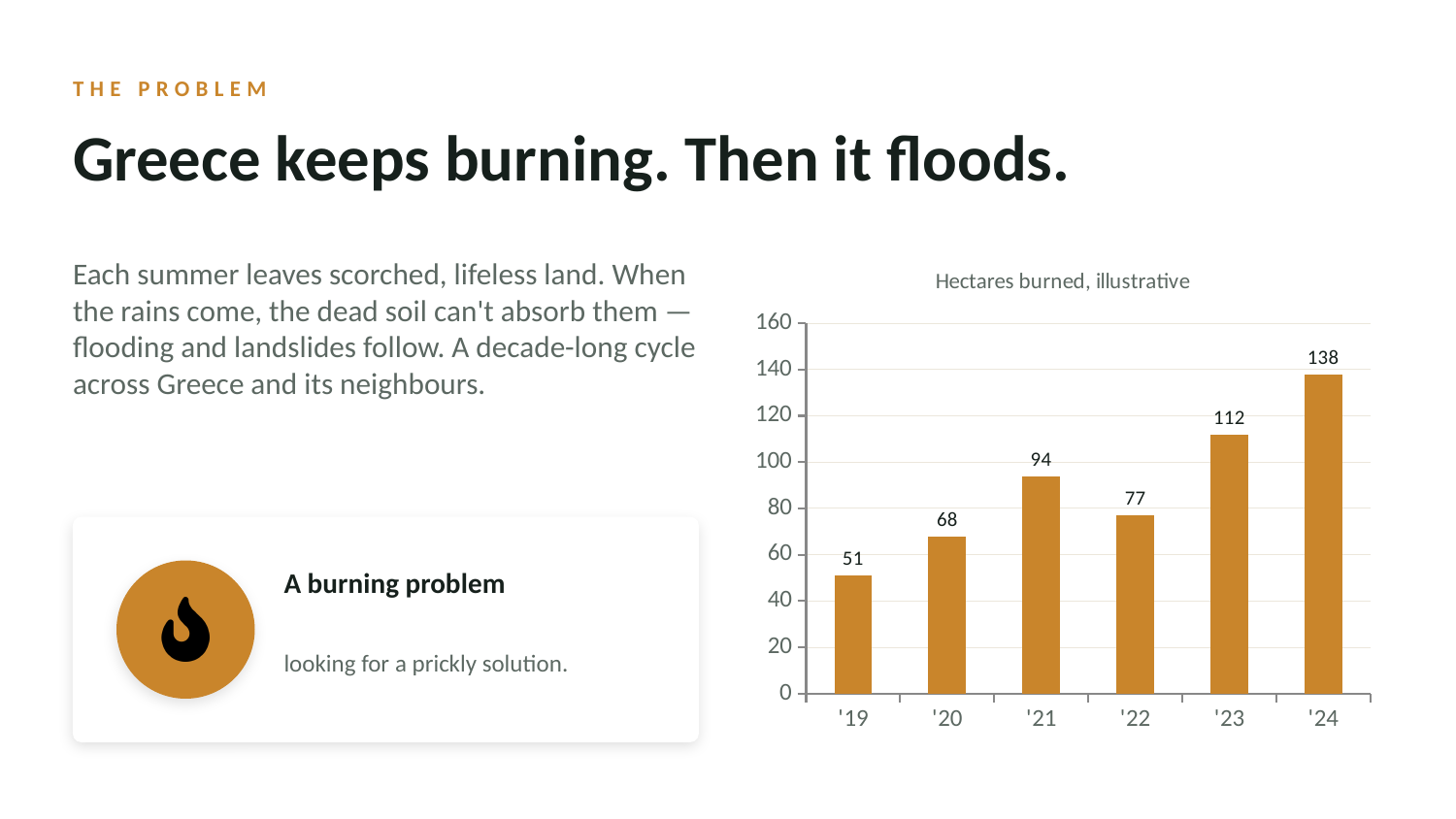
Do the values generally rise or fall from '19 to '24? rise What kind of chart is shown? bar chart Which is larger, the value for '21 or the value for '22? '21 Is the value for '23 greater or less than 100? greater What is the value for '21? 94 Which year has the highest value? '24 Which year has the lowest value? '19 What is the difference between the values for '20 and '19? 17 How many years are shown on the x axis? 6 What is the difference between the values for '24 and '23? 26 What is the title of the chart? Hectares burned, illustrative What is the value for '19? 51